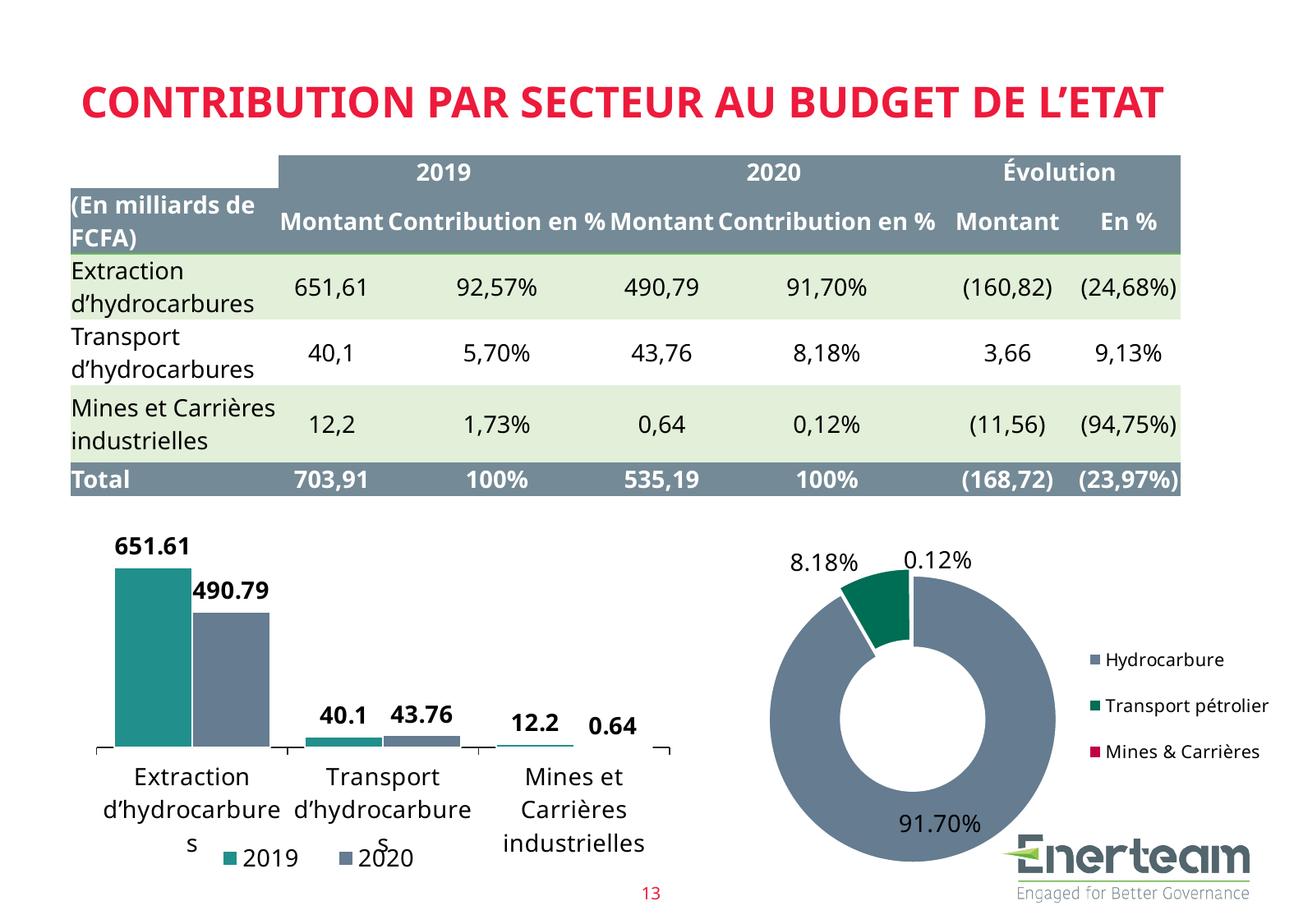
In the bar chart on the left, what is the 2020 value for Mines et Carrières industrielles? 0.64 How many categories are shown in the bar chart on the left? 3 In the doughnut chart on the right, which slice is the largest? Hydrocarbure In the bar chart on the left, what is the 2019 value for Extraction d'hydrocarbures? 651.61 In the bar chart on the left, which category has the lowest 2020 value? Mines et Carrières industrielles In the bar chart on the left, is the 2019 or the 2020 value larger for Transport d'hydrocarbures? 2020 How many series does the legend of the bar chart on the left list? 2 In the bar chart on the left, which category has the highest 2019 value? Extraction d'hydrocarbures In the doughnut chart on the right, what share does Transport pétrolier have? 8.18% In the bar chart on the left, what is the 2020 value for Transport d'hydrocarbures? 43.76 What kind of chart is shown on the right of the slide? Doughnut chart In the bar chart on the left, what is the difference between the 2019 and 2020 values for Extraction d'hydrocarbures? 160.82